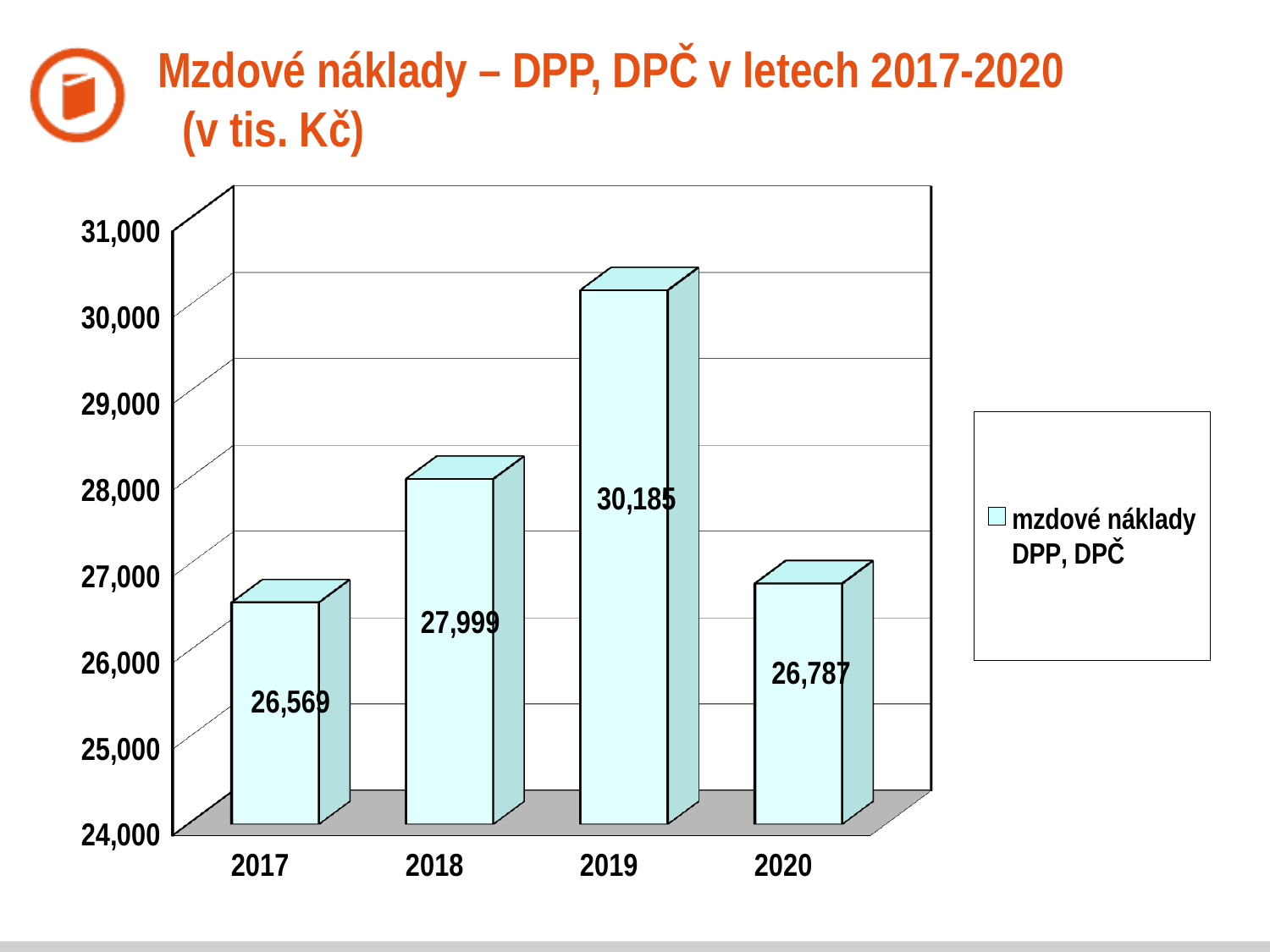
What series name does the legend show? mzdové náklady DPP, DPČ What kind of chart is shown? bar chart Is the value for 2019 greater or less than 30,000? greater Which is larger, the value for 2018 or the value for 2020? 2018 How many years are shown on the x axis? 4 What is the value for 2020? 26,787 What is the value for 2017? 26,569 What is the value for 2019? 30,185 Which year has the highest value? 2019 Which year has the lowest value? 2017 What is the difference between the values for 2019 and 2018? 2,186 What is the difference between the values for 2020 and 2017? 218